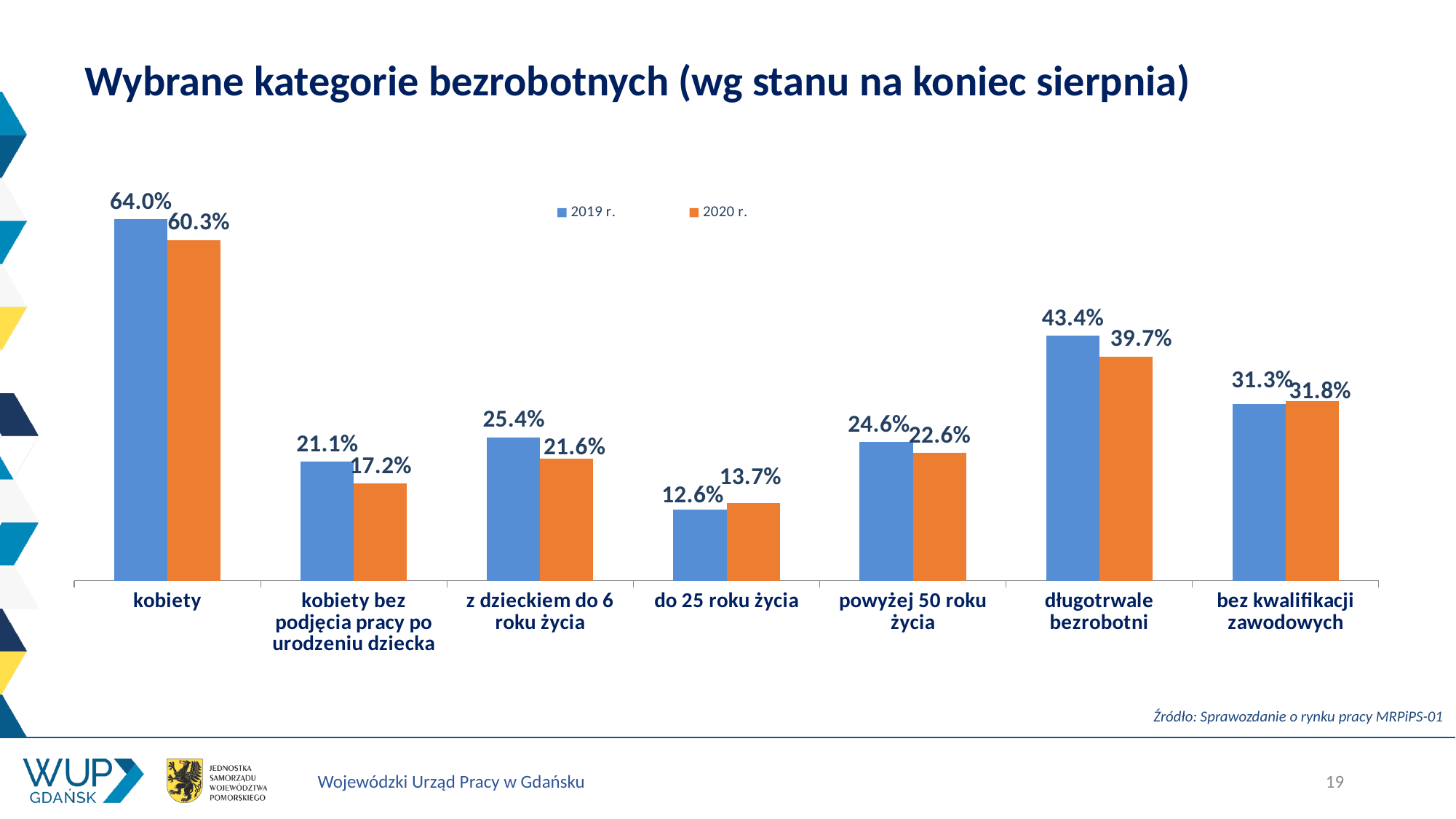
Which category has the highest value in the 2020 r. series? kobiety What is the difference between the 2019 r. and 2020 r. values for "długotrwale bezrobotni"? 3.7% How many series does the legend list? 2 For "powyżej 50 roku życia", which series has the larger value, 2019 r. or 2020 r.? 2019 r. What is the difference between the 2019 r. and 2020 r. values for "kobiety bez podjęcia pracy po urodzeniu dziecka"? 3.9% What kind of chart is shown on the slide? bar chart How many categories are shown on the x axis of the chart? 7 Which category has the lowest value in the 2019 r. series? do 25 roku życia For "bez kwalifikacji zawodowych", which series has the larger value, 2019 r. or 2020 r.? 2020 r. What is the value for "kobiety" in the 2019 r. series? 64.0% What is the value for "do 25 roku życia" in the 2019 r. series? 12.6% What is the value for "długotrwale bezrobotni" in the 2020 r. series? 39.7%